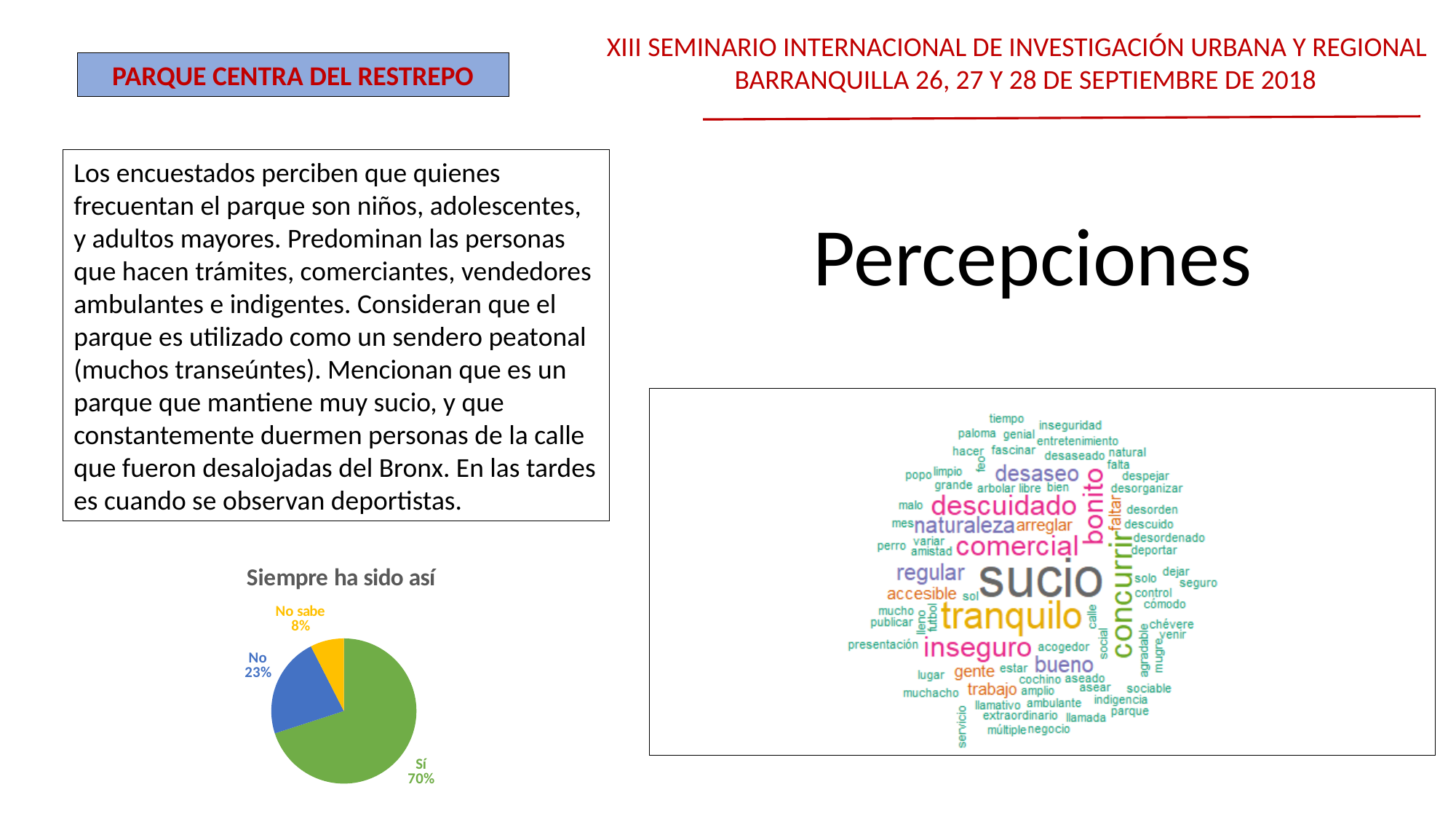
In the pie chart "Siempre ha sido así", what is the difference between the "Sí" and "No" shares? 47% In the pie chart "Siempre ha sido así", what share does "No" have? 23% In the pie chart "Siempre ha sido así", what share does "Sí" have? 70% In the pie chart "Siempre ha sido así", what share does "No sabe" have? 8% In the pie chart "Siempre ha sido así", which is larger, "No" or "No sabe"? No In the pie chart "Siempre ha sido así", what colour is the "Sí" slice? green What type of chart is "Siempre ha sido así"? pie chart How many slices does the pie chart "Siempre ha sido así" have? 3 In the pie chart "Siempre ha sido así", what is the combined share of "No" and "No sabe"? 31% Which slice of the pie chart "Siempre ha sido así" is the largest? Sí Which slice of the pie chart "Siempre ha sido así" is the smallest? No sabe What is the title of the pie chart? Siempre ha sido así